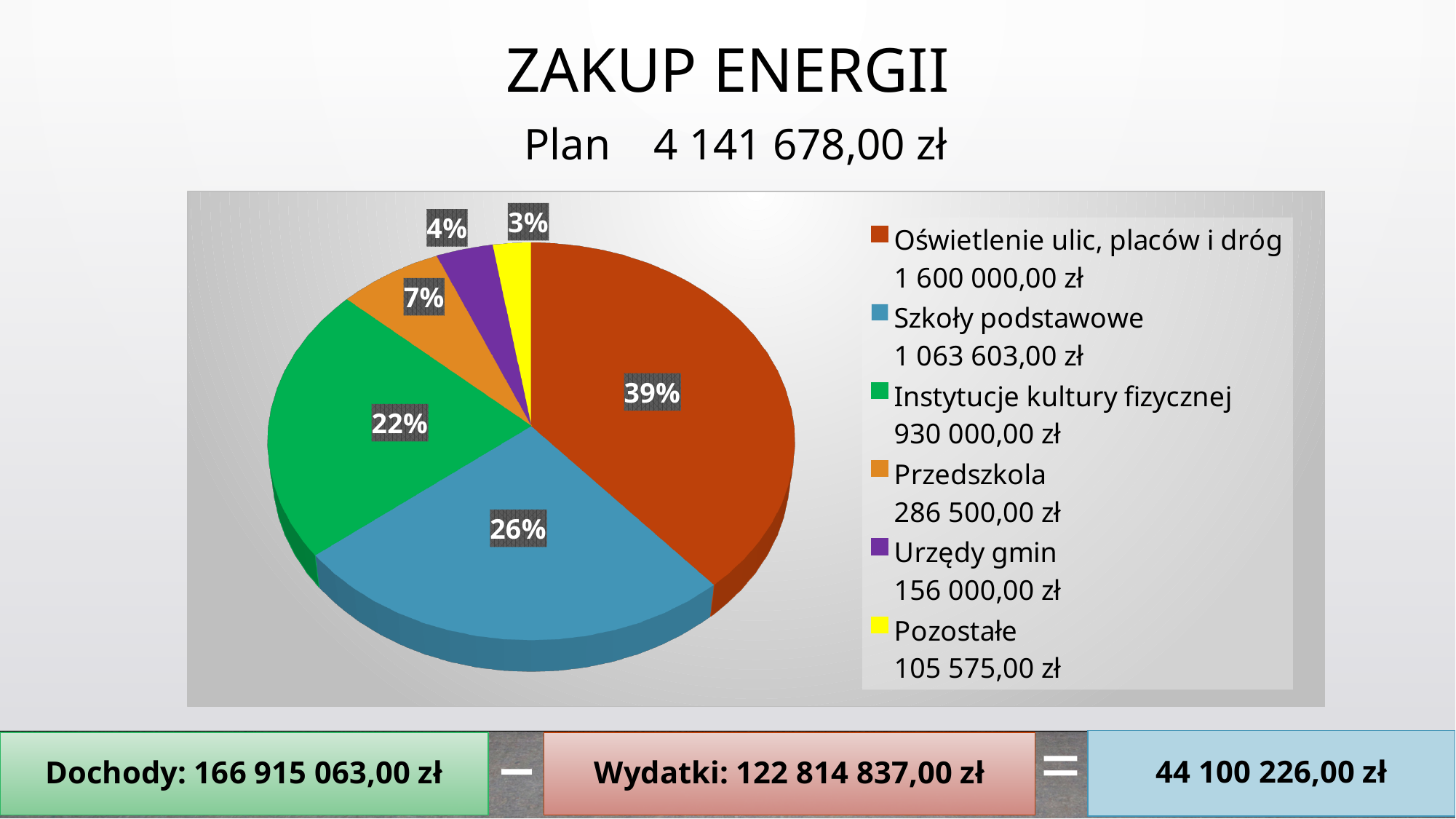
What type of chart is shown on the slide? pie chart What is the difference between the values for Oświetlenie ulic, placów i dróg and Szkoły podstawowe? 536 397,00 zł Which category has the largest slice of the pie? Oświetlenie ulic, placów i dróg What is the difference between the values for Urzędy gmin and Pozostałe? 50 425,00 zł What is the value for Szkoły podstawowe? 1 063 603,00 zł How many categories does the pie chart show? 6 What share of the pie does Oświetlenie ulic, placów i dróg represent? 39% Which category has the smallest slice of the pie? Pozostałe What is the value for Przedszkola? 286 500,00 zł What share of the pie does Instytucje kultury fizycznej represent? 22% Which is larger, the value for Instytucje kultury fizycznej or the value for Przedszkola? Instytucje kultury fizycznej What is the value for Pozostałe? 105 575,00 zł